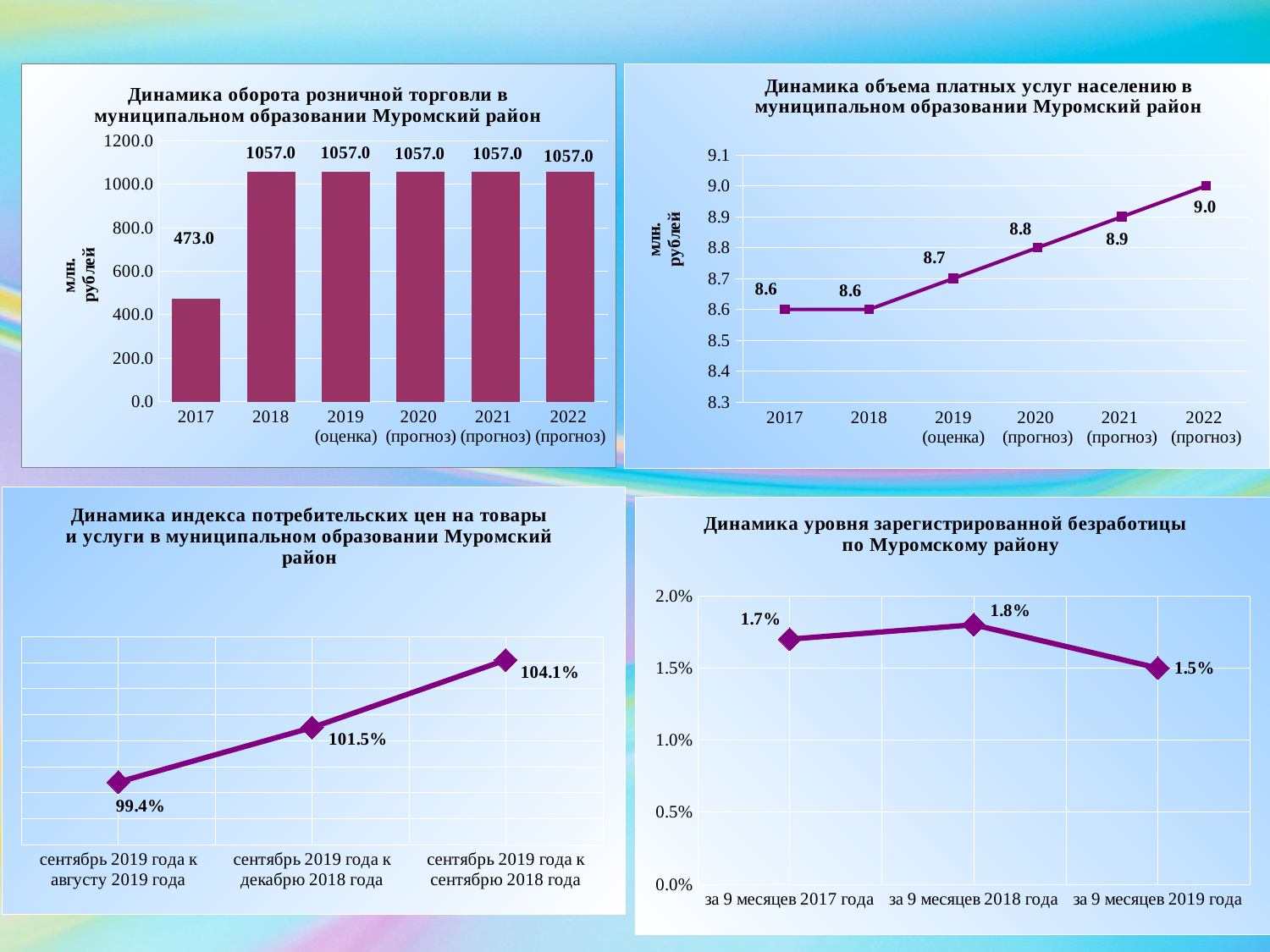
In the top-left chart (Динамика оборота розничной торговли), what is the difference between the 2018 value and the 2017 value? 584.0 In the top-left chart (Динамика оборота розничной торговли), what is the value for 2017? 473.0 In the top-right chart (Динамика объема платных услуг населению), which year has the highest value? 2022 (прогноз) In the bottom-left chart (Динамика индекса потребительских цен), which category has the lowest value? сентябрь 2019 года к августу 2019 года In the bottom-right chart (Динамика уровня зарегистрированной безработицы), what is the value for за 9 месяцев 2019 года? 1.5% In the top-right chart (Динамика объема платных услуг населению), do the values rise or fall from 2018 to 2022? rise In the top-right chart (Динамика объема платных услуг населению), what is the value for 2019 (оценка)? 8.7 In the bottom-left chart (Динамика индекса потребительских цен), what is the value for сентябрь 2019 года к декабрю 2018 года? 101.5% In the top-left chart (Динамика оборота розничной торговли), what is the value for 2020 (прогноз)? 1057.0 How many years are shown on the x axis of the top-left chart (Динамика оборота розничной торговли)? 6 In the bottom-right chart (Динамика уровня зарегистрированной безработицы), which is larger: the value for за 9 месяцев 2017 года or за 9 месяцев 2018 года? за 9 месяцев 2018 года What kind of chart is the top-left chart (Динамика оборота розничной торговли)? bar chart